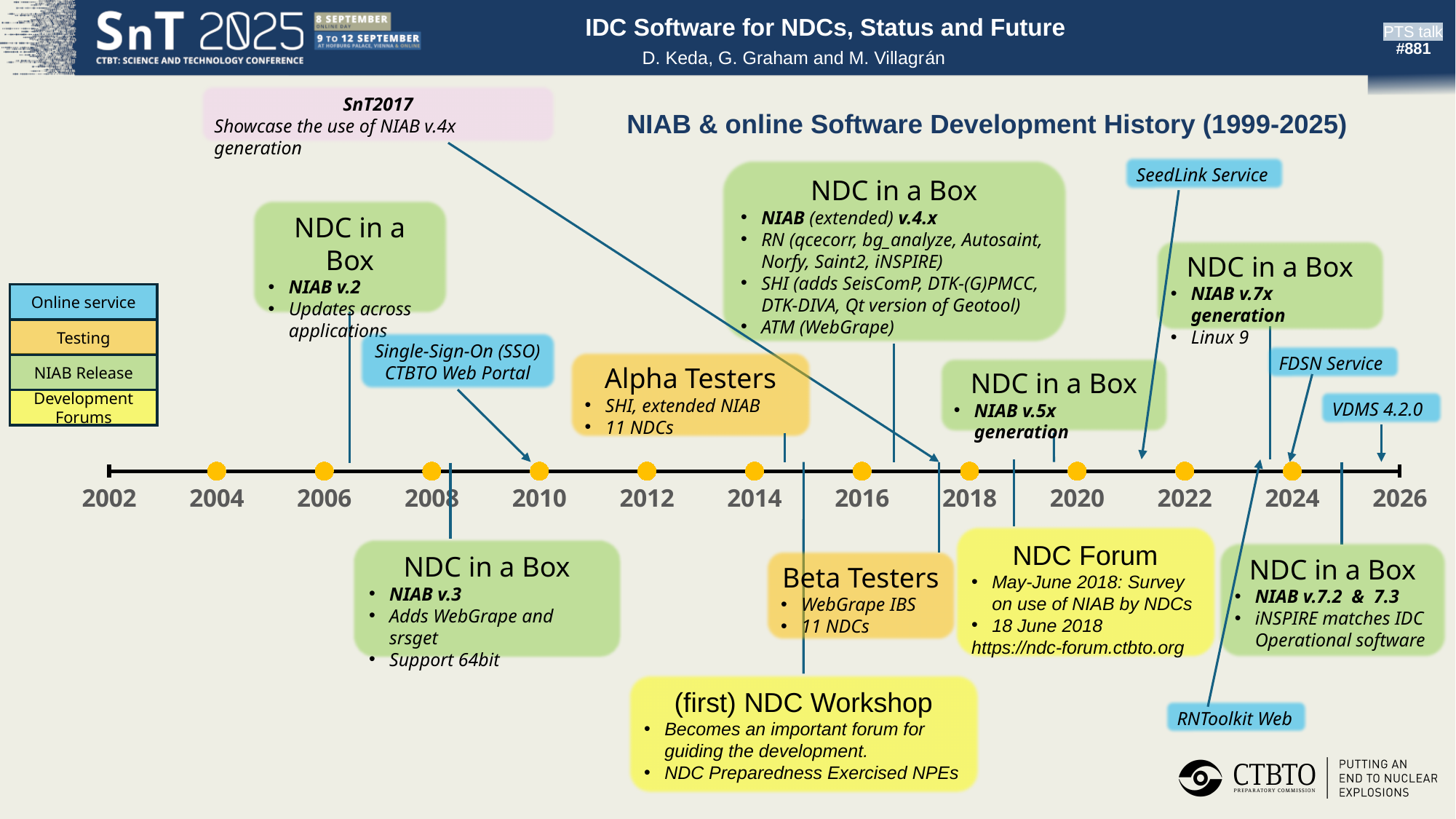
Which is later on the timeline, the Beta Testers entry or the Alpha Testers entry? Beta Testers How many categories does the legend of the timeline list? 4 What kind of chart is shown on the slide? Timeline What is the latest year labelled on the timeline axis? 2026 Which legend category is shown in yellow? Development Forums What is the title of the timeline chart? NIAB & online Software Development History (1999-2025) What is the earliest year labelled on the timeline axis? 2002 How many NDCs are listed in the Alpha Testers box? 11 NDCs What is the interval between consecutive year labels on the timeline axis? 2 years How many year labels are printed along the timeline axis? 13 Which NIAB version is listed in the NDC in a Box entry placed above the 2018 tick? NIAB v.5x generation Do the years increase or decrease from left to right along the timeline axis? Increase